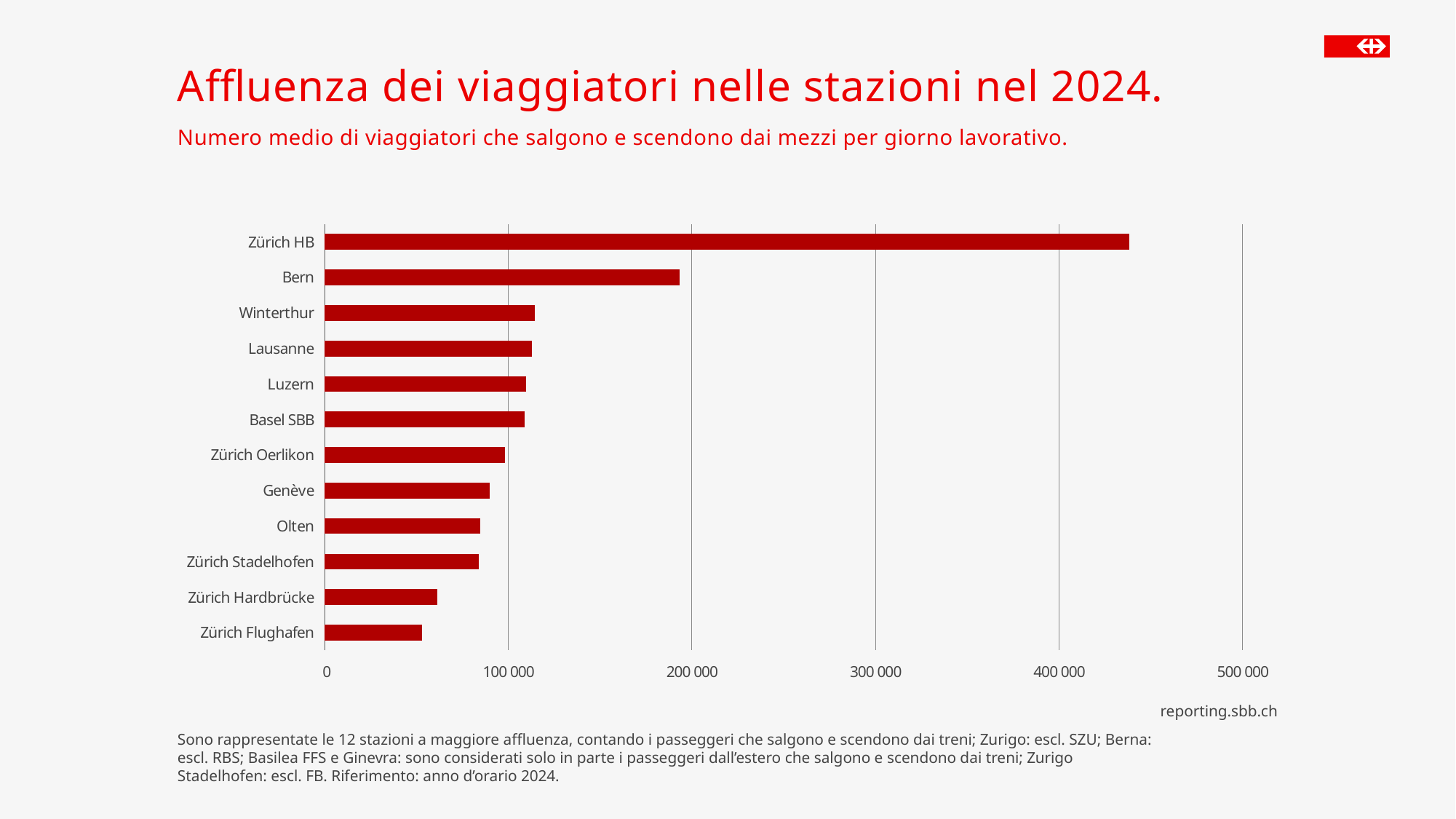
Is the value for Bern greater or less than 200 000? less Which station has the highest number of passengers? Zürich HB What is the highest value shown on the horizontal axis? 500 000 Which has a higher value, Zürich Hardbrücke or Zürich Flughafen? Zürich Hardbrücke Is the value for Zürich HB greater or less than 400 000? greater What is the title of the chart on the slide? Affluenza dei viaggiatori nelle stazioni nel 2024. Which station has the lowest number of passengers? Zürich Flughafen Is the value for Genève greater or less than 100 000? less How many stations are shown in the chart? 12 Which has a higher value, Bern or Winterthur? Bern What kind of chart is shown on the slide? bar chart